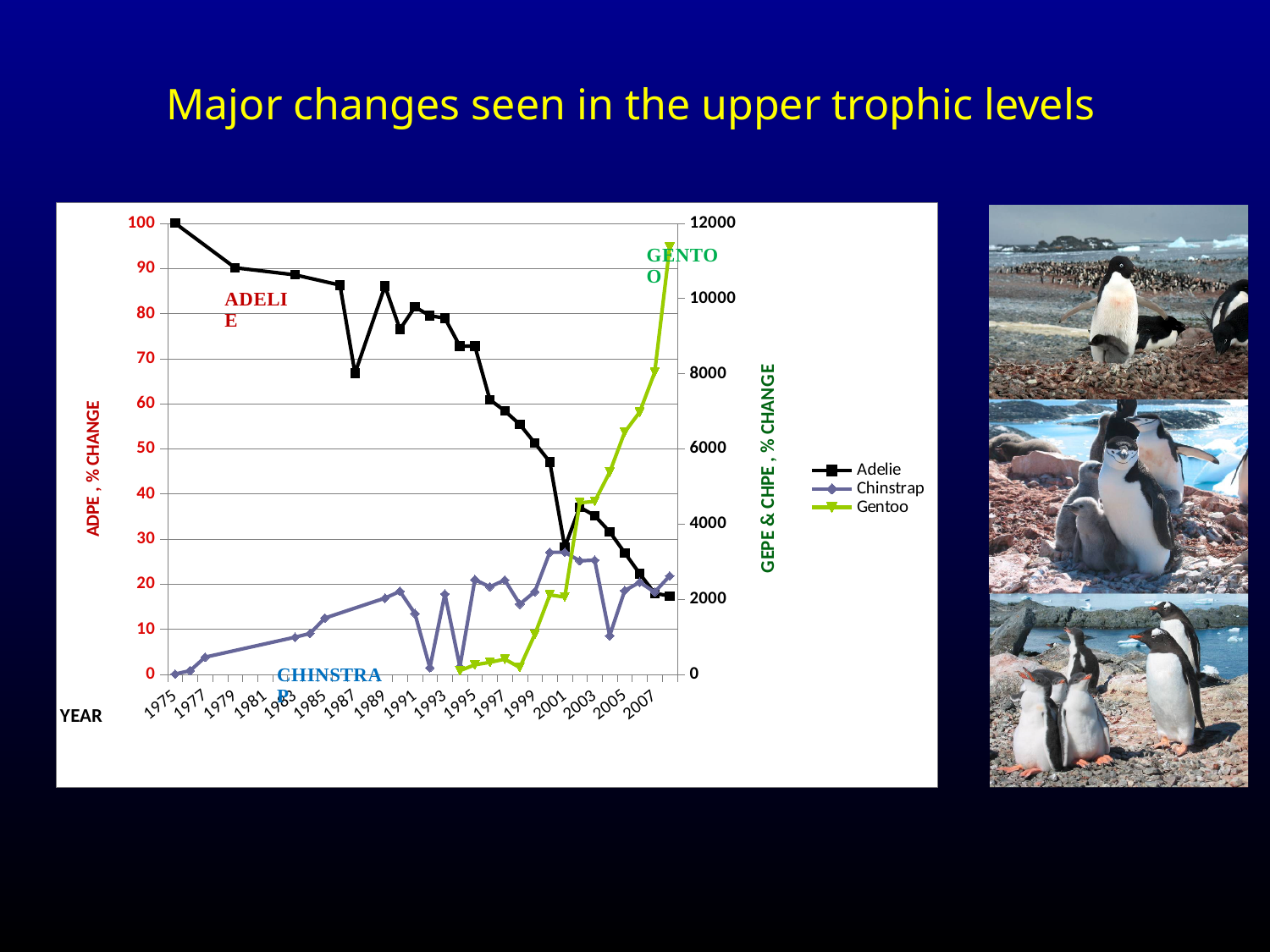
What is the label of the right-hand vertical axis? GEPE & CHPE , % CHANGE Does the Adelie series rise or fall from 1975 to 2007? fall What is the Adelie value in 1975 on the left axis? 100 What kind of chart is shown on the slide? line chart How many series does the legend list? 3 In 2007, which is larger on the right axis, Gentoo or Chinstrap? Gentoo Does the Gentoo series rise or fall over the years shown? rise Is the Adelie value for 1979 greater or less than 80? greater Is the Gentoo value for 2004 greater or less than 6000? less Is the Chinstrap value for 2001 greater or less than 4000? less Which series are listed in the legend? Adelie, Chinstrap, Gentoo